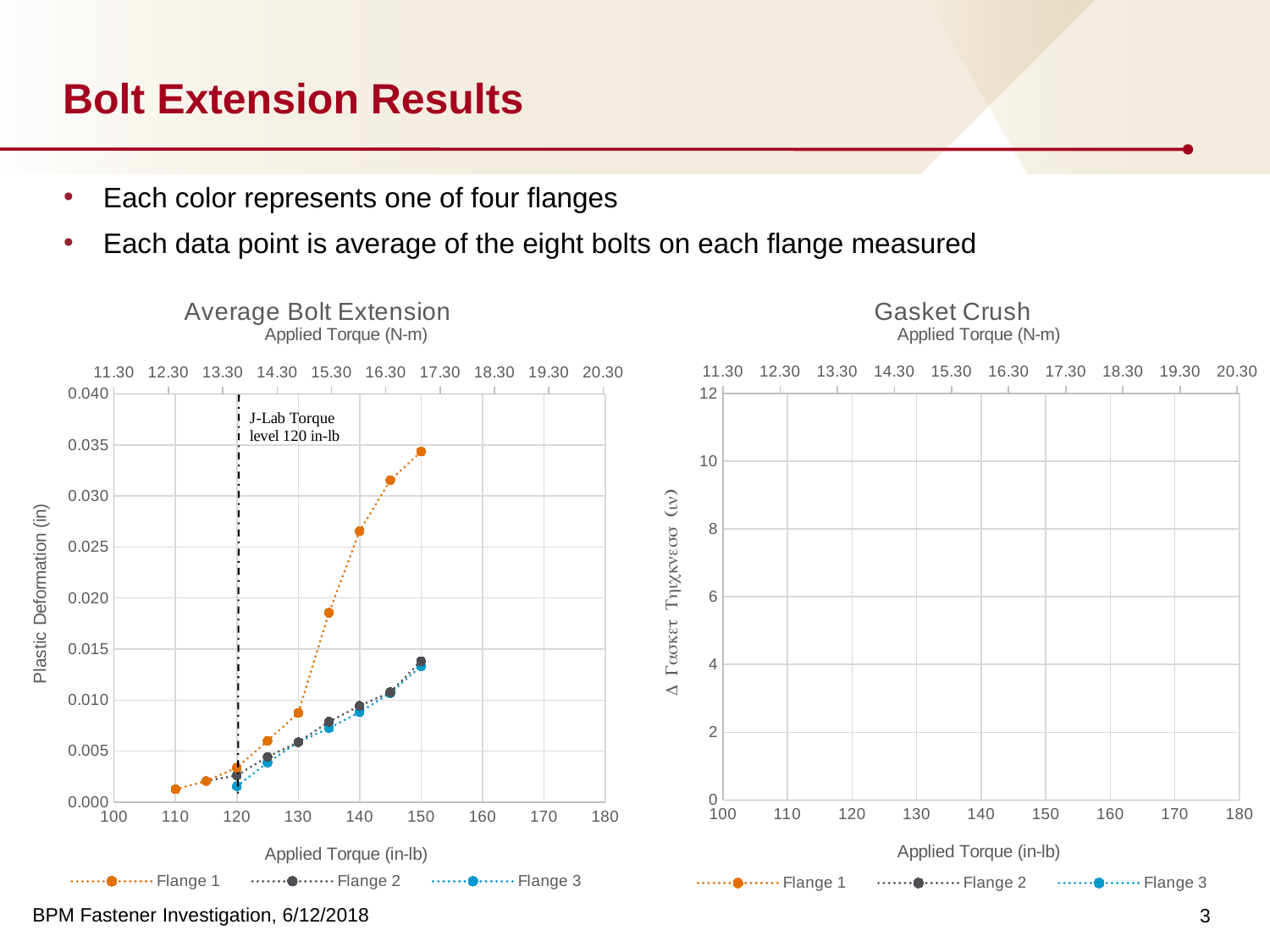
In the Average Bolt Extension chart, is the Flange 1 value at 140 in-lb greater or less than 0.025? greater In the Average Bolt Extension chart, is the Flange 3 value at 140 in-lb greater or less than 0.010? less In the Average Bolt Extension chart, which flange has the highest plastic deformation at 150 in-lb applied torque? Flange 1 In the Average Bolt Extension chart, at 140 in-lb applied torque, which is larger: Flange 1 or Flange 2? Flange 1 How many data points are plotted for Flange 1 in the Average Bolt Extension chart? 9 What kind of chart is the Average Bolt Extension chart on the left? line chart How many series does the legend of the Gasket Crush chart on the right list? 3 In the Average Bolt Extension chart, is the Flange 1 value at 130 in-lb greater or less than 0.010? less What torque level does the dashed vertical line in the Average Bolt Extension chart mark? J-Lab Torque level 120 in-lb How many series does the legend of the Average Bolt Extension chart list? 3 In the Average Bolt Extension chart, does the plastic deformation for Flange 1 rise or fall as applied torque increases? rise